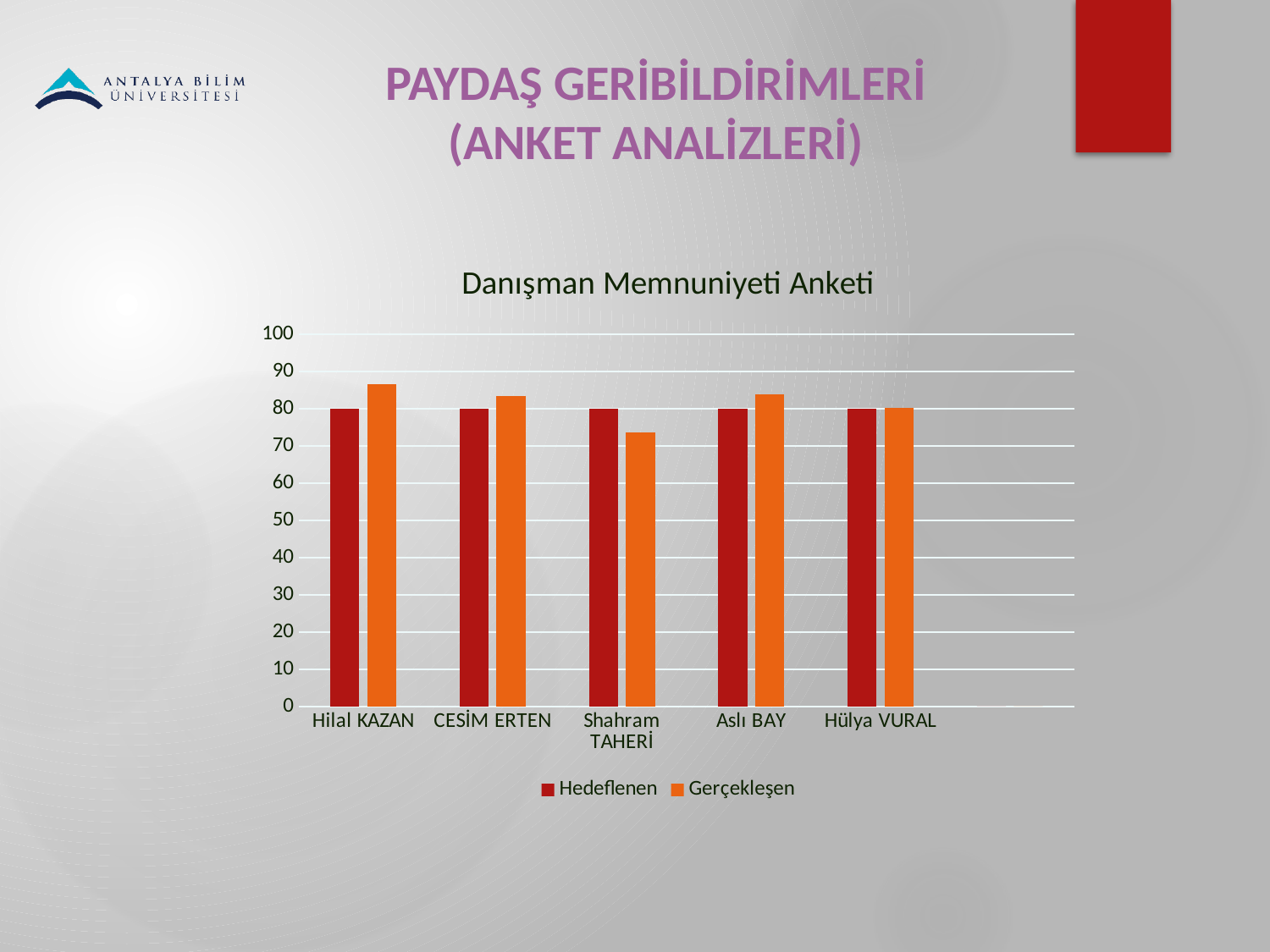
Is the Gerçekleşen value for Shahram TAHERİ greater or less than 80? less What is the Hedeflenen value for Shahram TAHERİ? 80 Is the Gerçekleşen value for Hilal KAZAN greater or less than 80? greater Is the Gerçekleşen value for Aslı BAY greater or less than 90? less What type of chart is shown on the slide? bar chart What is the Hedeflenen value for Hilal KAZAN? 80 How many categories are shown on the x axis? 5 Which is larger for Hilal KAZAN, the Hedeflenen value or the Gerçekleşen value? Gerçekleşen Which series is shown in orange in the legend? Gerçekleşen How many series does the legend list? 2 Which category has the lowest Gerçekleşen value? Shahram TAHERİ What is the title of the chart? Danışman Memnuniyeti Anketi